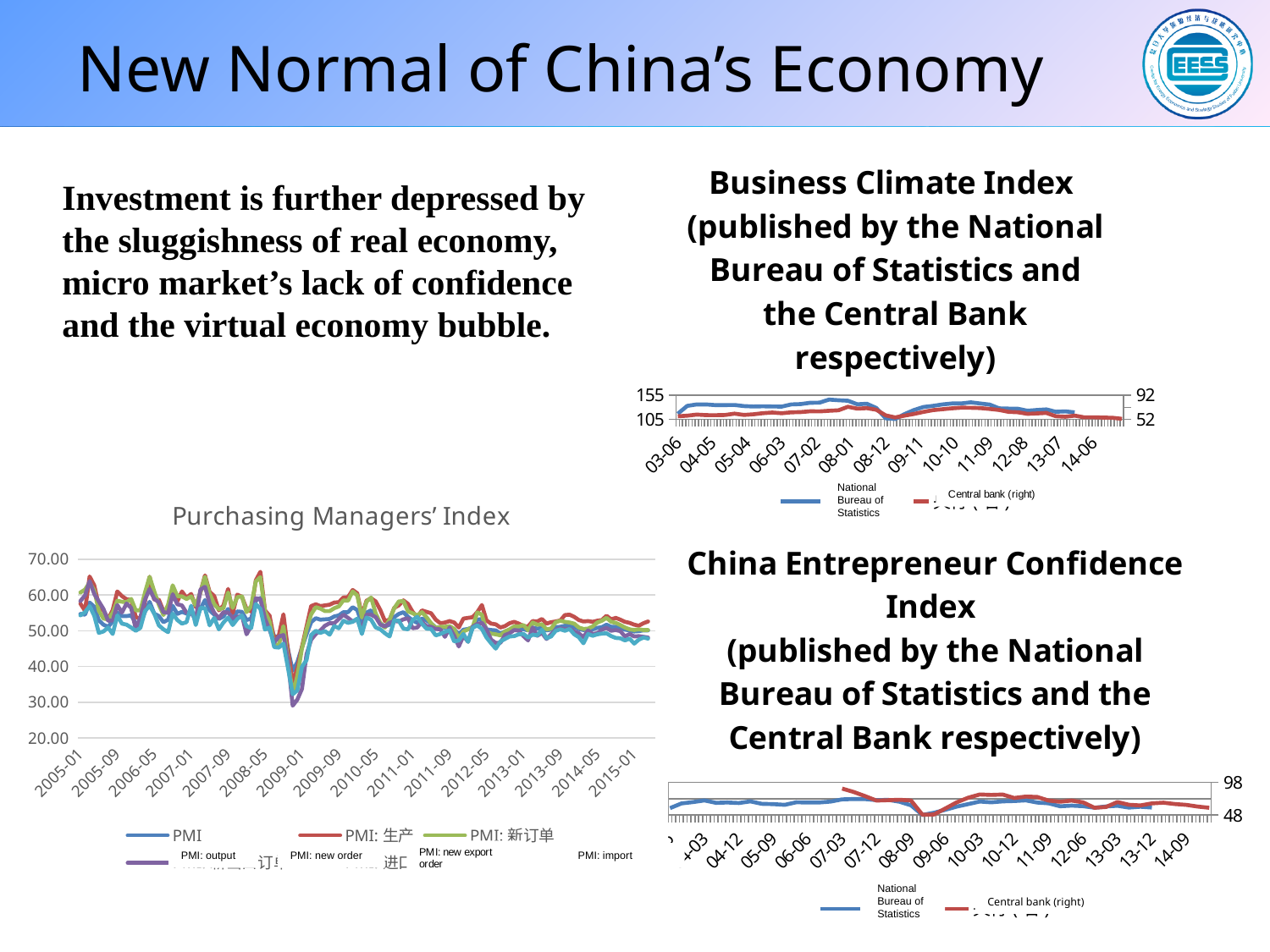
In the China Entrepreneur Confidence Index chart, what are the two values shown on the right axis? 98 and 48 In the Purchasing Managers' Index chart, is the PMI value at 2005-01 greater or less than 50.00? greater How many series does the legend of the Purchasing Managers' Index chart list? 5 In the Purchasing Managers' Index chart, is the PMI value at 2015-01 greater or less than 60.00? less What is the highest value shown on the y-axis of the Purchasing Managers' Index chart? 70.00 How many series does the legend of the Business Climate Index chart list? 2 What kind of chart is the Purchasing Managers' Index chart? Line chart In the Purchasing Managers' Index chart, is the lowest point of the PMI: new export order series (around 2009-01) greater or less than 40.00? less What kind of chart is the Business Climate Index chart? Line chart In the Business Climate Index chart, which series is plotted on the right axis according to the legend? Central bank (right) How many series does the legend of the China Entrepreneur Confidence Index chart list? 2 In the Purchasing Managers' Index chart, do the series generally rise or fall between 2008-05 and 2009-01? fall